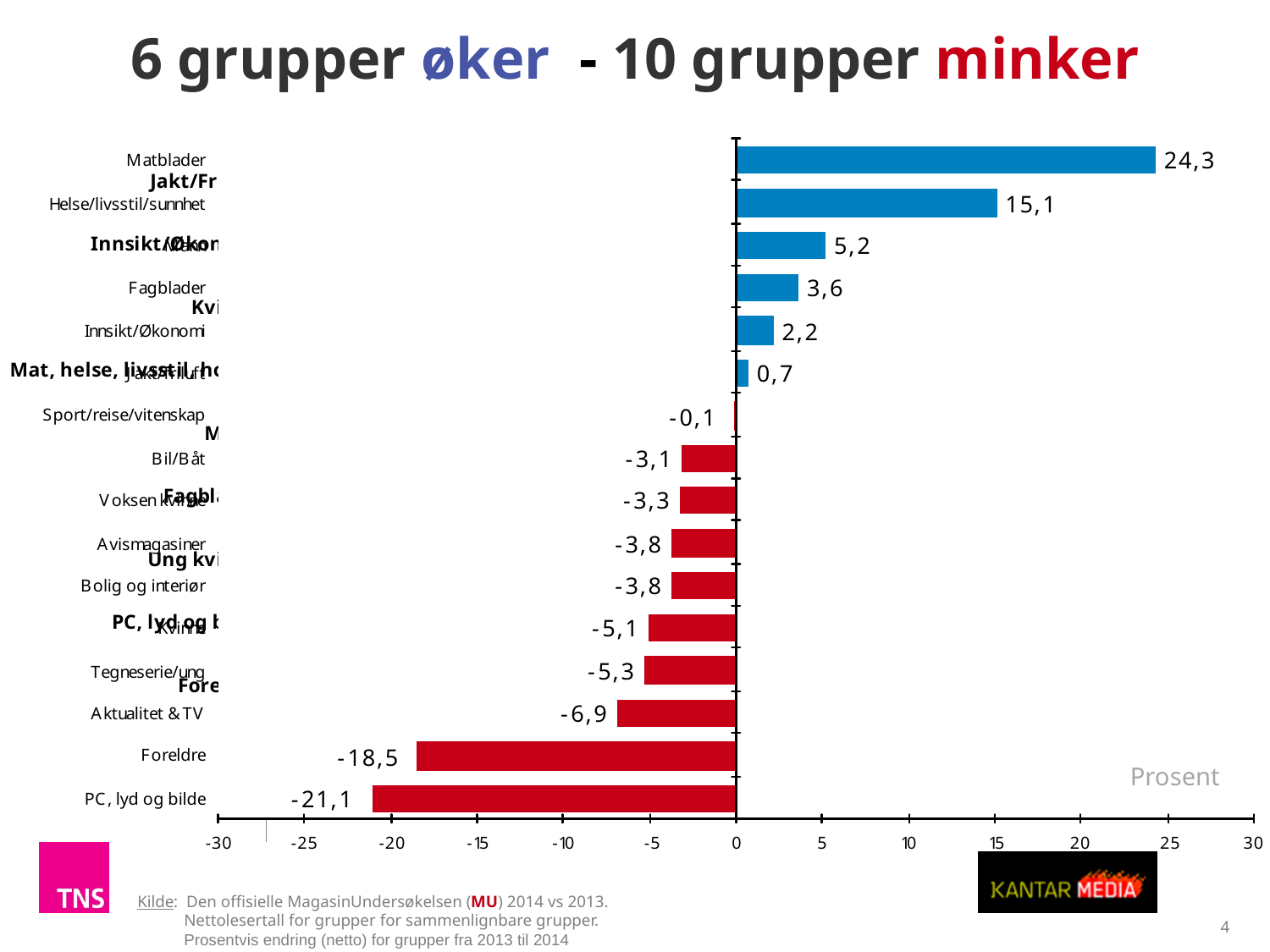
What is the value for Helse/livsstil/sunnhet? 15,1 What is the value for Aktualitet & TV? -6,9 What is the value for PC, lyd og bilde? -21,1 Which has a larger value, Tegneserie/ung or Bil/Båt? Bil/Båt Which category has the lowest value? PC, lyd og bilde How many categories are plotted in the chart? 16 What is the value for Foreldre? -18,5 Which category has the highest value? Matblader What is the difference between the values for Matblader and Helse/livsstil/sunnhet? 9,2 What is the value for Matblader? 24,3 What is the value for Fagblader? 3,6 What kind of chart is shown on the slide? Bar chart